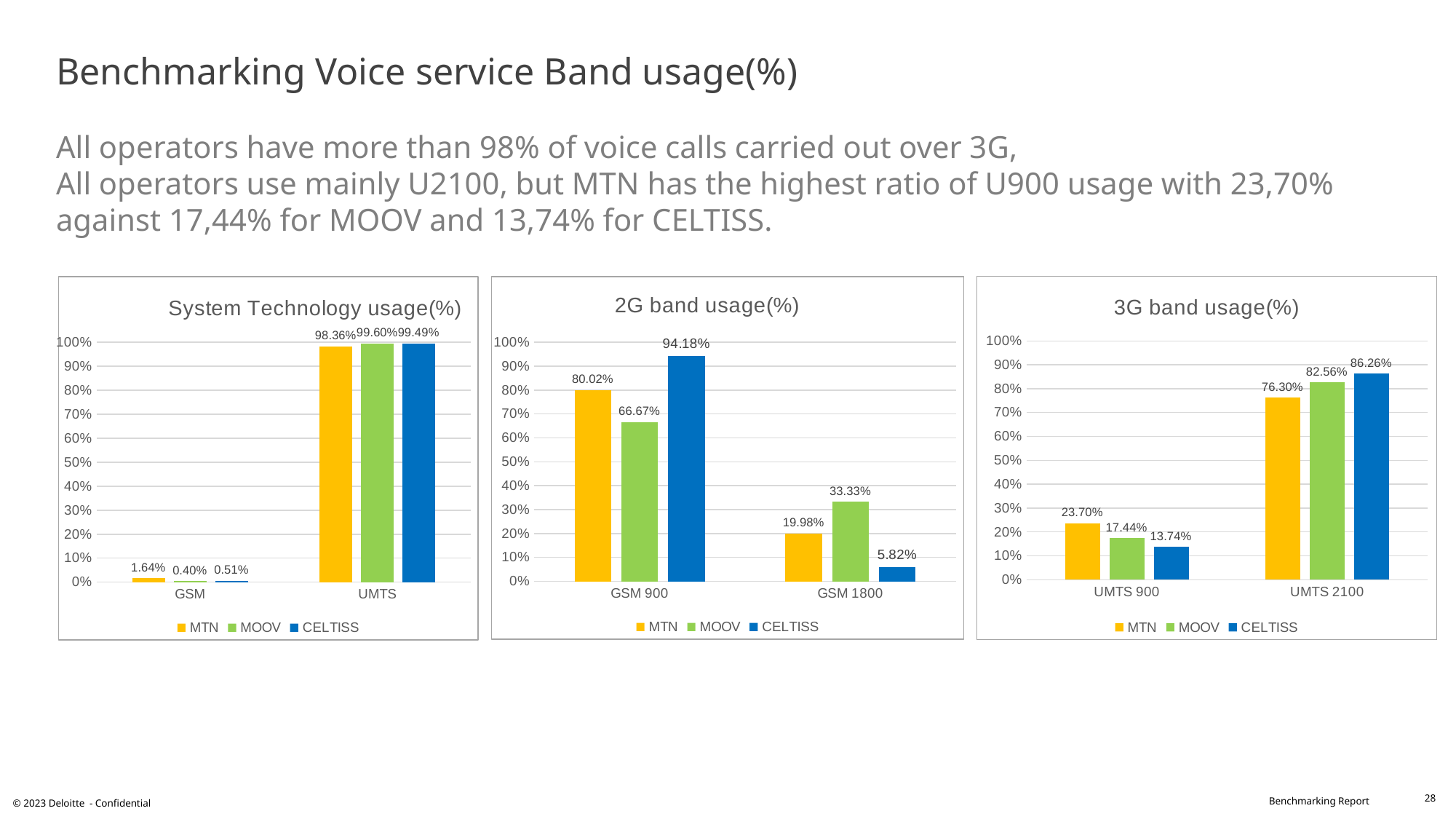
How many categories are shown on the x axis of the '3G band usage(%)' chart? 2 How many series does the legend of the '2G band usage(%)' chart list? 3 In the 'System Technology usage(%)' chart, which is larger at GSM: the MTN value or the CELTISS value? MTN In the '2G band usage(%)' chart, is the value for MTN at GSM 900 greater or less than 70%? greater In the '2G band usage(%)' chart, which operator has the highest value at GSM 1800? MOOV In the '3G band usage(%)' chart, what is the value for MTN at UMTS 900? 23.70% In the '3G band usage(%)' chart, what is the difference between the CELTISS and MTN values at UMTS 2100? 9.96% In the '3G band usage(%)' chart, which operator has the lowest value at UMTS 900? CELTISS What kind of chart is the 'System Technology usage(%)' chart? Bar chart In the 'System Technology usage(%)' chart, what is the value for MOOV at UMTS? 99.60% In the '2G band usage(%)' chart, what is the difference between the CELTISS and MOOV values at GSM 900? 27.51% In the '2G band usage(%)' chart, what is the value for CELTISS at GSM 900? 94.18%